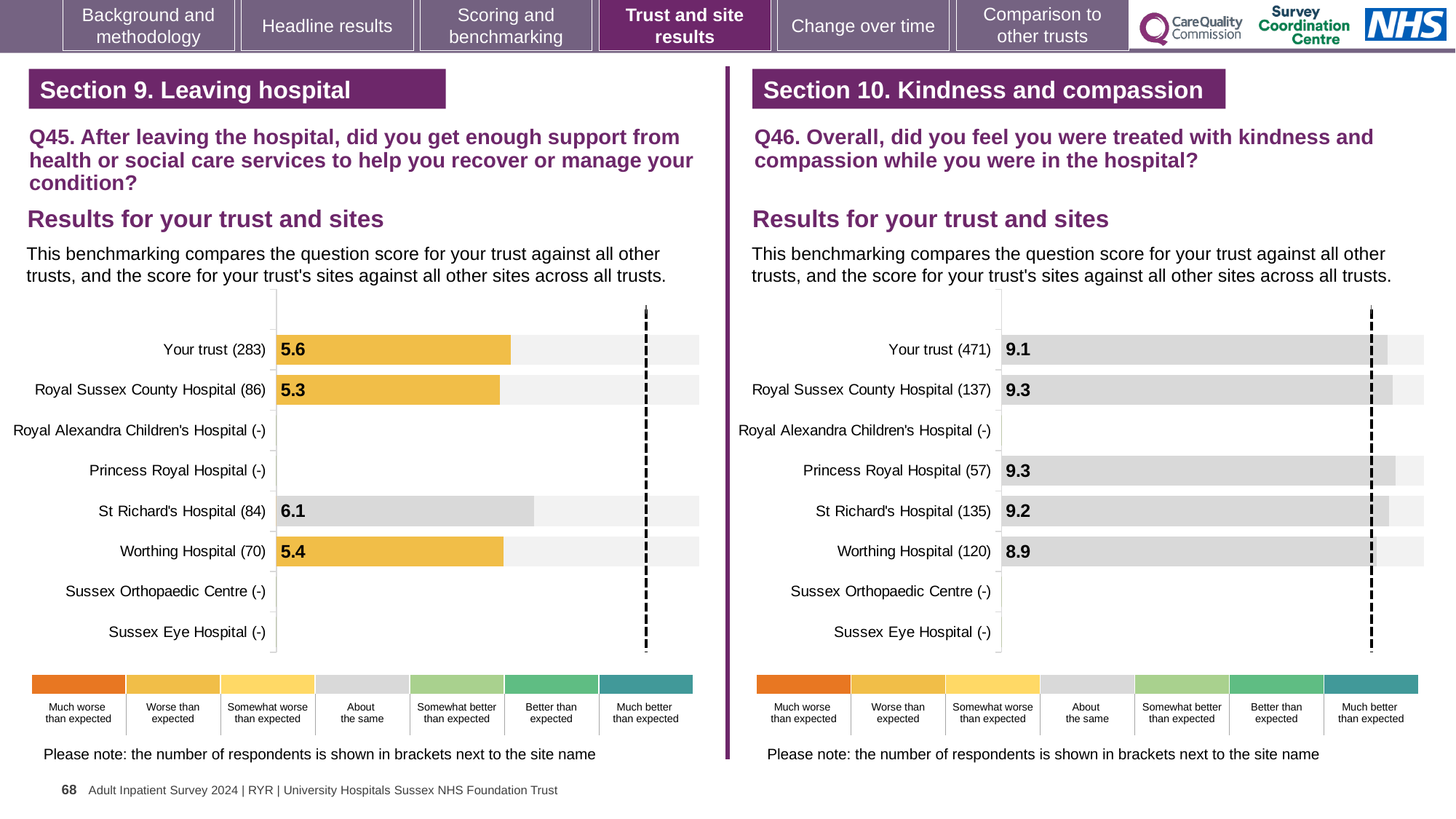
In the Q45 chart on the left, which site has the highest score? St Richard's Hospital In the Q45 chart on the left, which site has the lowest score? Royal Sussex County Hospital In the Q45 chart on the left, what is the score for St Richard's Hospital? 6.1 In the Q46 chart on the right, what is the difference between the scores for Princess Royal Hospital and Worthing Hospital? 0.4 In the Q45 chart on the left, what is the score for Your trust? 5.6 What kind of chart is used in the Q45 chart on the left? Bar chart In the Q46 chart on the right, which site has the lowest score? Worthing Hospital In the Q45 chart on the left, what is the difference between the scores for St Richard's Hospital and Royal Sussex County Hospital? 0.8 In the Q46 chart on the right, what is the score for Worthing Hospital? 8.9 In the Q45 chart on the left, how many sites have a score shown as a bar? 3 In the Q46 chart on the right, which is larger: the score for Royal Sussex County Hospital or the score for Worthing Hospital? Royal Sussex County Hospital In the Q46 chart on the right, what is the score for Your trust? 9.1